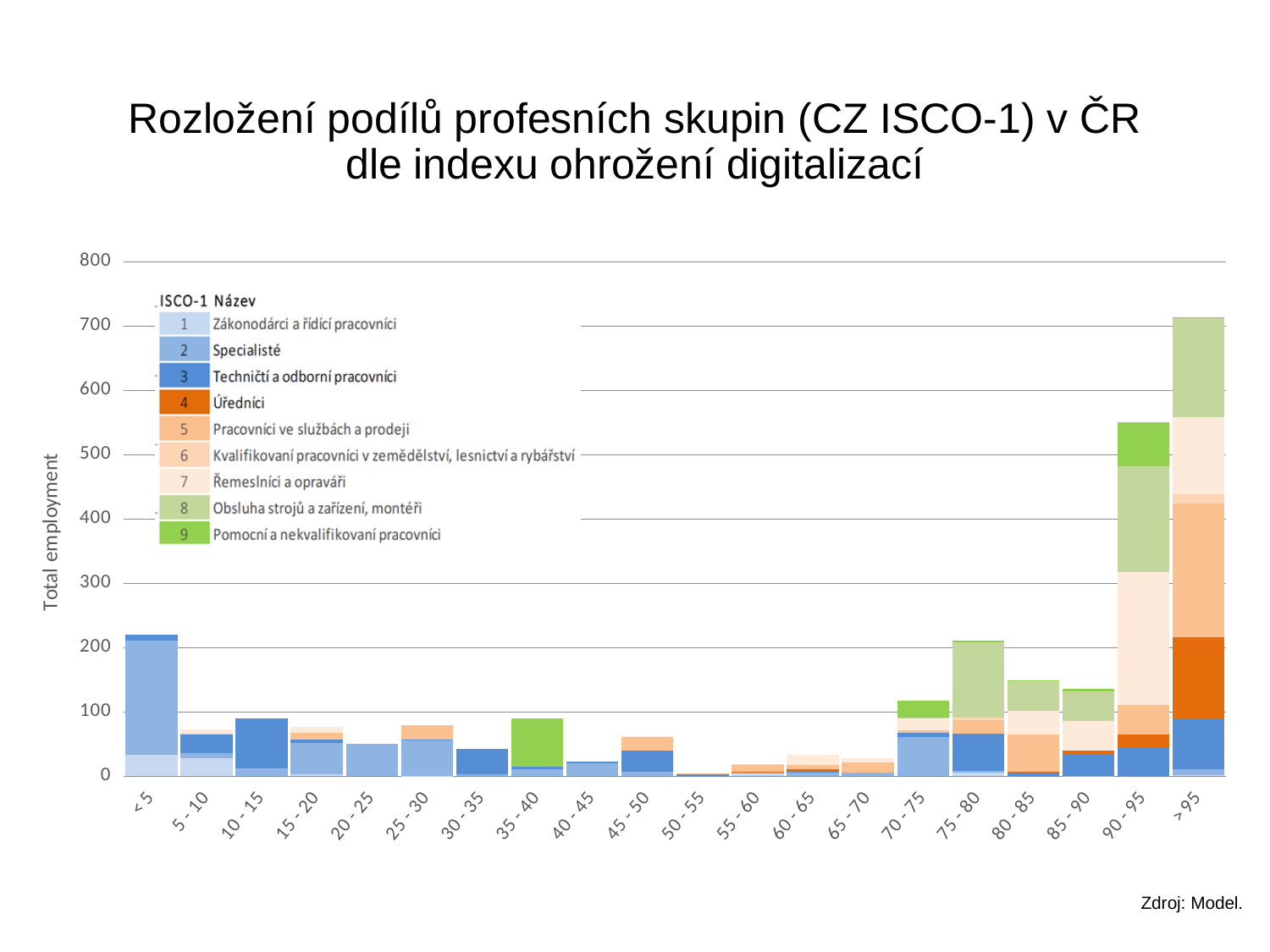
What kind of chart is shown on the slide? Stacked bar chart Which x-axis category has the tallest stacked bar? > 95 Is the total for the "10 - 15" category greater or less than 100? less Is the total for the "90 - 95" category greater or less than 500? greater How many ISCO-1 groups does the legend list? 9 How many categories (index ranges) are shown along the x axis? 20 Which has the larger total, the "75 - 80" category or the "80 - 85" category? 75 - 80 Which x-axis category has the shortest stacked bar? 50 - 55 Is the total for the "> 95" category greater or less than 700? greater Which ISCO-1 group is listed as number 9 in the legend? Pomocní a nekvalifikovaní pracovníci What is the label of the y axis? Total employment